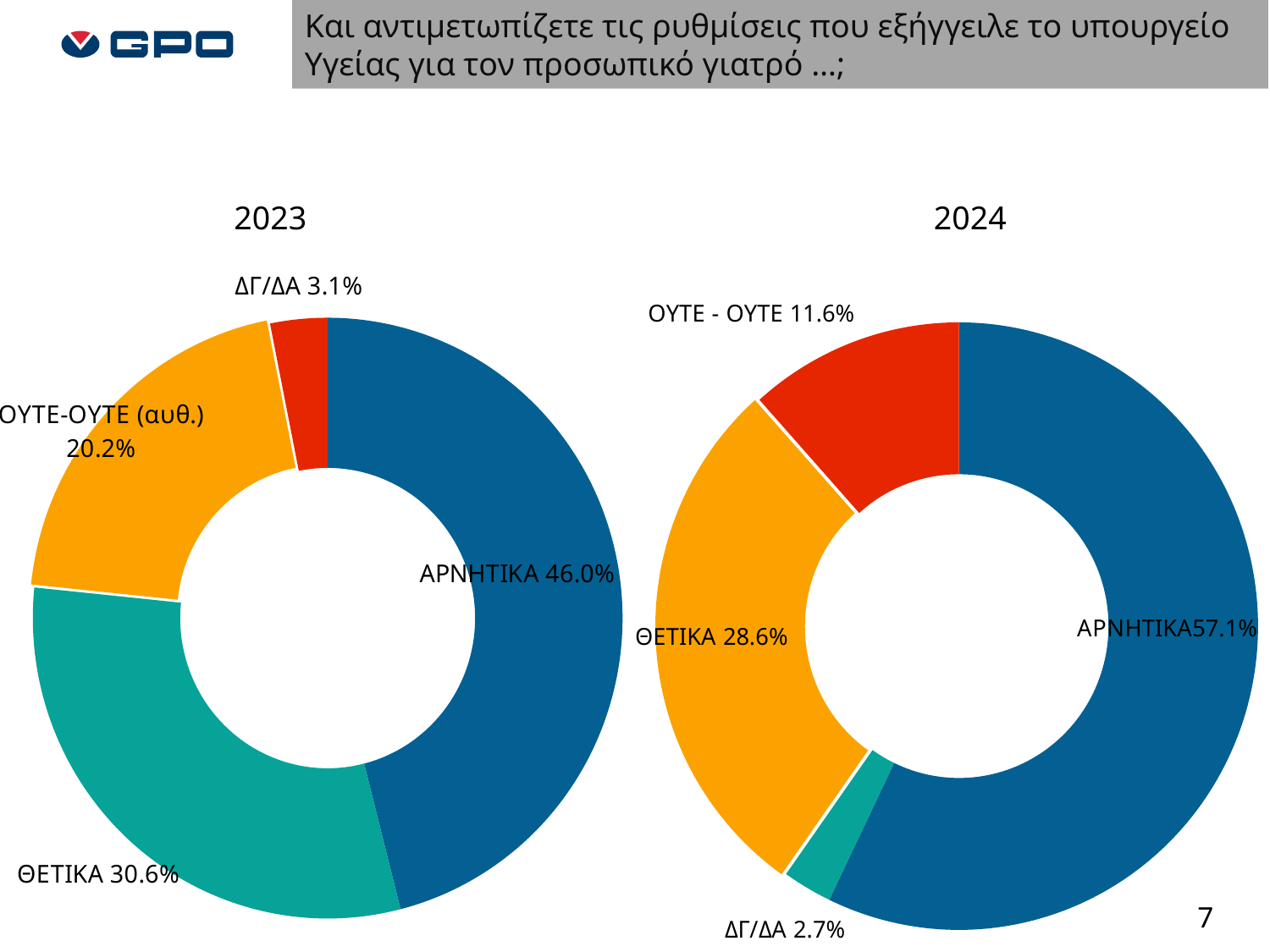
In the 2023 chart, what is the difference between ΘΕΤΙΚΑ and ΟΥΤΕ-ΟΥΤΕ (αυθ.)? 10.4% What colour is the ΑΡΝΗΤΙΚΑ slice in both charts? Dark blue In the 2023 chart, what is the value for ΑΡΝΗΤΙΚΑ? 46.0% In the 2024 chart, what is the value for ΔΓ/ΔΑ? 2.7% What is the difference between the ΑΡΝΗΤΙΚΑ value in the 2024 chart and the ΑΡΝΗΤΙΚΑ value in the 2023 chart? 11.1% In the 2024 chart, which category has the largest share? ΑΡΝΗΤΙΚΑ What kind of chart is the 2023 chart? Doughnut chart In the 2024 chart, what is the value for ΘΕΤΙΚΑ? 28.6% How many categories does the 2024 chart show? 4 In the 2023 chart, which category has the smallest share? ΔΓ/ΔΑ Which is larger: ΘΕΤΙΚΑ in the 2023 chart or ΘΕΤΙΚΑ in the 2024 chart? ΘΕΤΙΚΑ in the 2023 chart In the 2023 chart, what is the value for ΟΥΤΕ-ΟΥΤΕ (αυθ.)? 20.2%